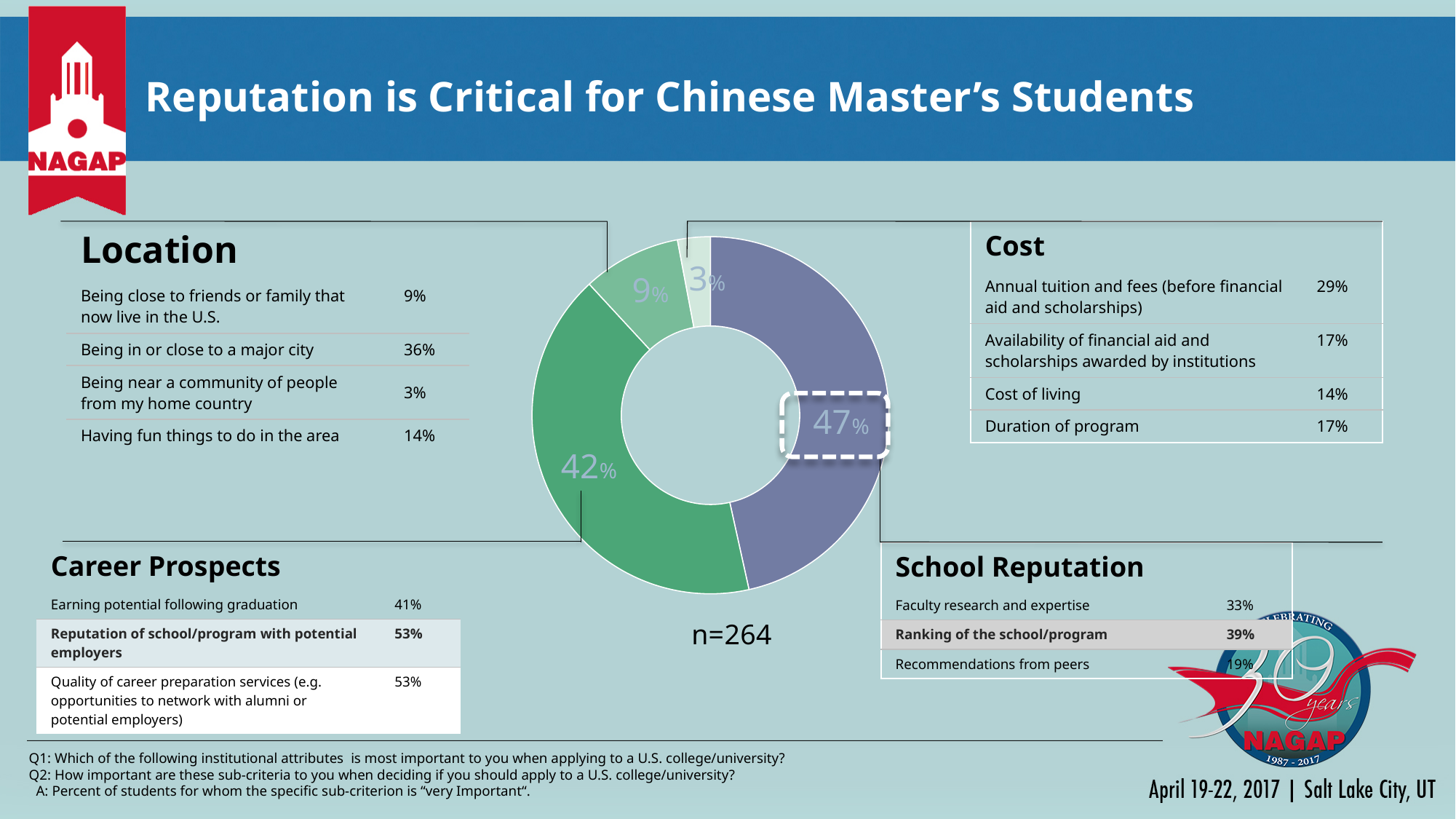
How many slices does the donut chart have? 4 What is the combined share of the 9% and 3% slices of the donut chart? 12% What share of the donut chart is linked to the Location box? 9% What kind of chart is shown in the centre of the slide? Donut (pie) chart What percentage is shown for the largest slice of the donut chart? 47% Which is larger in the donut chart: the slice linked to School Reputation or the slice linked to Career Prospects? School Reputation Which slice of the donut chart is highlighted with a dashed box? 47% What percentage is shown for the smallest slice of the donut chart? 3% What share of the donut chart is linked to the Career Prospects box? 42% What is the difference between the 47% slice and the 42% slice of the donut chart? 5% What sample size (n) is printed below the donut chart? n=264 What share of the donut chart is linked to the Cost box? 3%